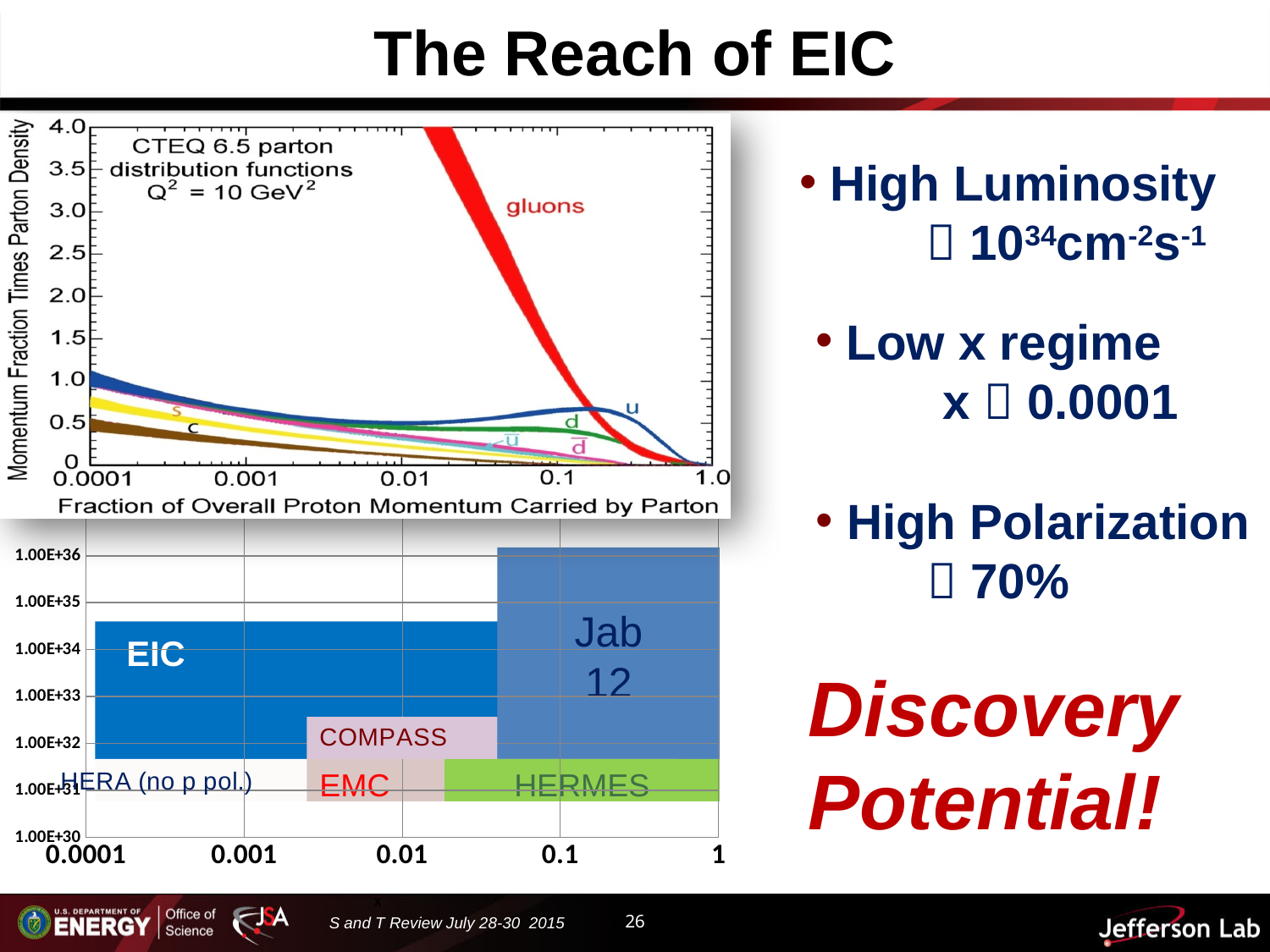
In the bottom chart, is the top of the EIC region greater or less than 1.00E+34? greater In the top chart, does the gluon curve rise or fall as the fraction of proton momentum increases from 0.01 to 1.0? fall In the bottom chart, which experiment region reaches the highest luminosity? Jab 12 In the bottom chart, how many experiment regions are labeled? 6 In the top chart, what is the maximum value shown on the y axis? 4.0 In the top chart, is the gluon density at x = 0.01 greater or less than 1.0? greater In the bottom chart, which region reaches higher luminosity, EIC or COMPASS? EIC What kind of chart is the top chart (CTEQ 6.5 parton distribution functions)? line chart In the top chart, what value of Q² is stated for the parton distribution functions? 10 GeV² In the top chart, which parton has the highest momentum fraction times parton density at x = 0.0001? gluons In the top chart, how many labeled parton curves are shown? 7 In the bottom chart, what is the lowest x value shown on the x axis? 0.0001